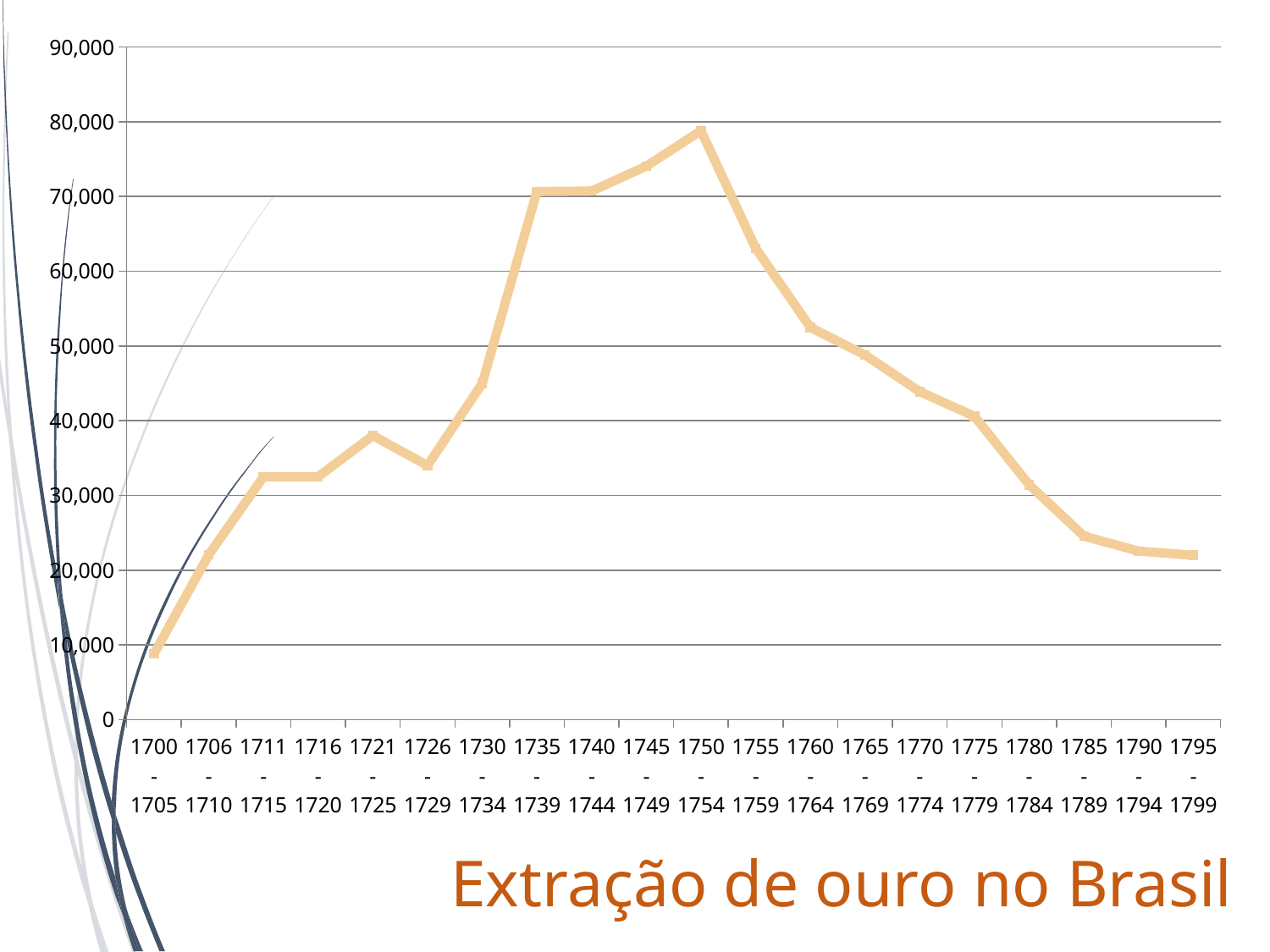
Is the value for 1730-1734 greater or less than 40,000? greater How many periods are plotted along the x axis? 20 Which is larger, the value for 1735-1739 or the value for 1760-1764? 1735-1739 Which is larger, the value for 1721-1725 or the value for 1726-1729? 1721-1725 Is the value for 1700-1705 greater or less than 10,000? less Which period has the highest value? 1750-1754 Which period has the lowest value? 1700-1705 What kind of chart is shown on the slide? line chart Is the value for 1750-1754 greater or less than 70,000? greater What is the title of the chart? Extração de ouro no Brasil Do the values rise or fall from 1750-1754 to 1795-1799? fall